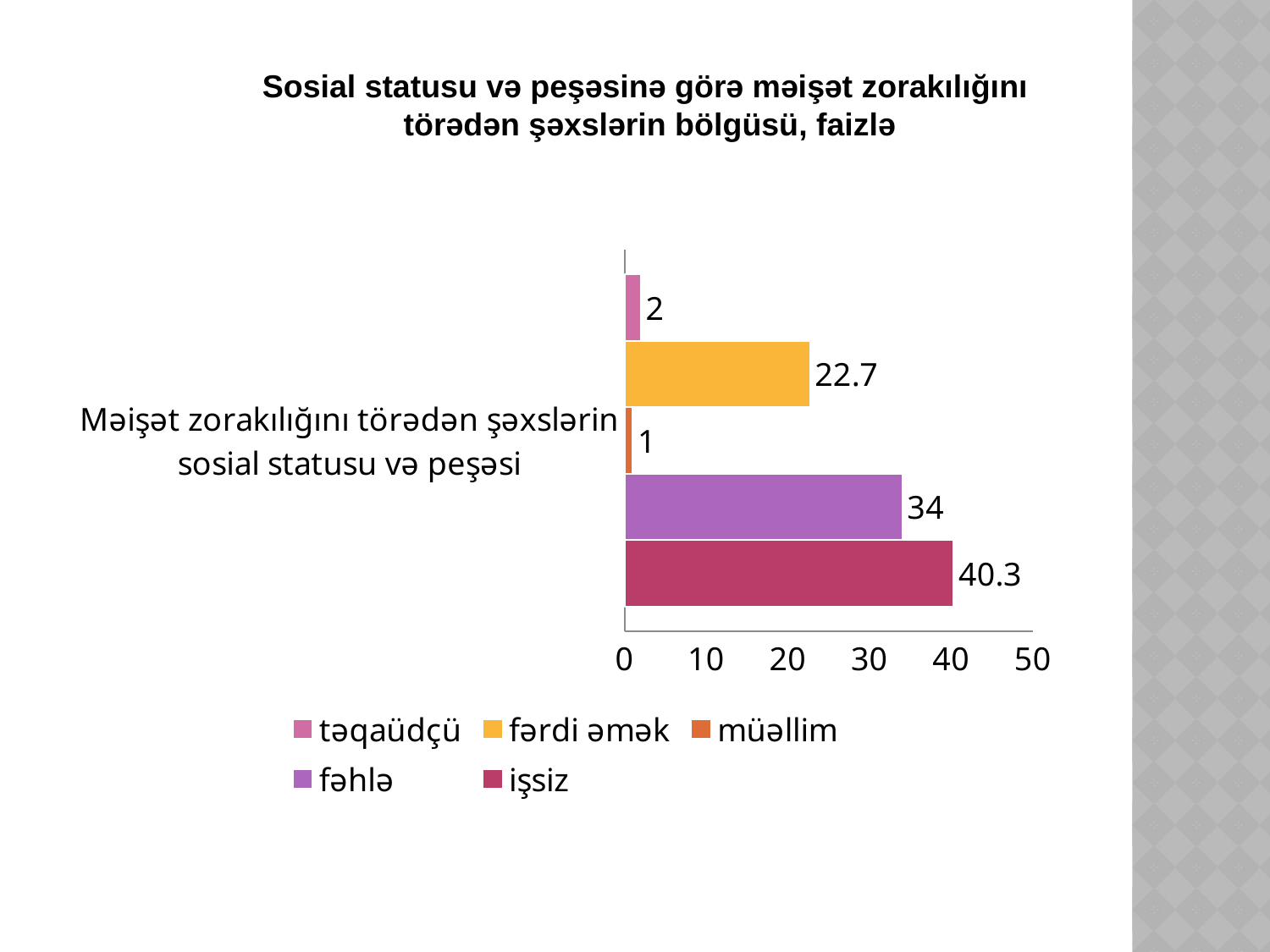
Which is larger, the value for fərdi əmək or the value for fəhlə? fəhlə What is the value for fəhlə? 34 What is the difference between the values for işsiz and fəhlə? 6.3 Which series has the lowest value? müəllim What is the value for təqaüdçü? 2 Which series has the highest value? işsiz How many series does the legend list? 5 What is the title of the chart? Sosial statusu və peşəsinə görə məişət zorakılığını törədən şəxslərin bölgüsü, faizlə What is the value for işsiz? 40.3 What kind of chart is shown on the slide? bar chart What is the value for müəllim? 1 What is the value for fərdi əmək? 22.7